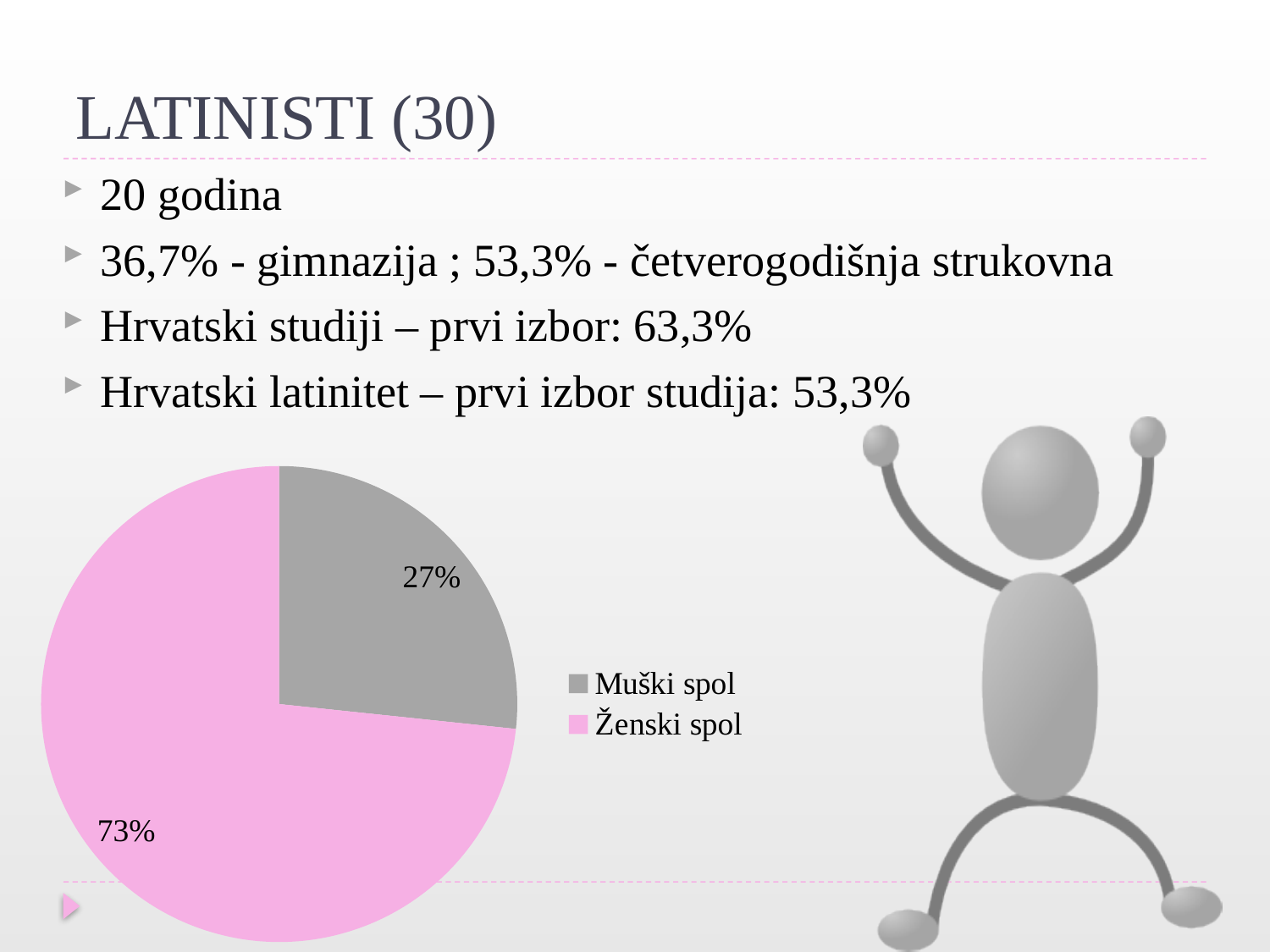
Which slice of the pie is the largest? Ženski spol What colour is the Ženski spol slice? pink Which slice of the pie is the smallest? Muški spol What kind of chart is shown on the slide? pie chart How many slices does the pie chart have? 2 What colour is the Muški spol slice? grey How many entries does the legend list? 2 What share of the pie is labelled Ženski spol? 73% Which is larger, the Muški spol slice or the Ženski spol slice? Ženski spol What share of the pie is labelled Muški spol? 27% What is the difference in percentage points between the Ženski spol and Muški spol slices? 46